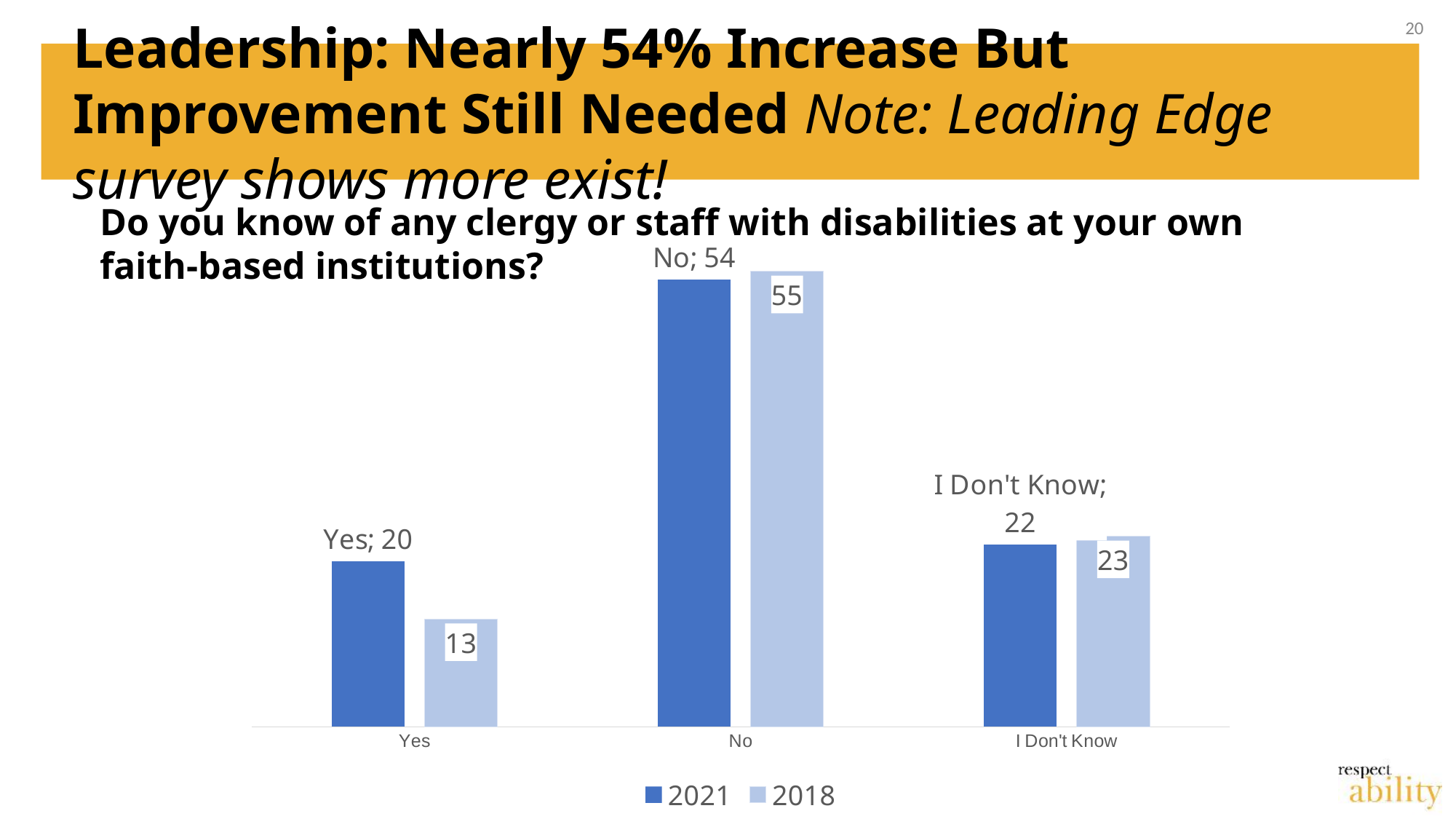
What kind of chart is shown on the slide? Bar chart How many series does the legend list? 2 What is the difference between the 2021 and 2018 values for "Yes"? 7 What is the 2021 value for the "Yes" category? 20 Which category has the lowest 2018 value? Yes Which is larger for the "Yes" category: the 2021 value or the 2018 value? 2021 What are the two series named in the legend? 2021 and 2018 How many categories are shown on the x axis? 3 What is the 2018 value for the "No" category? 55 Which category has the highest 2021 value? No What is the difference between the 2021 values for "No" and "Yes"? 34 What is the 2018 value for the "I Don't Know" category? 23